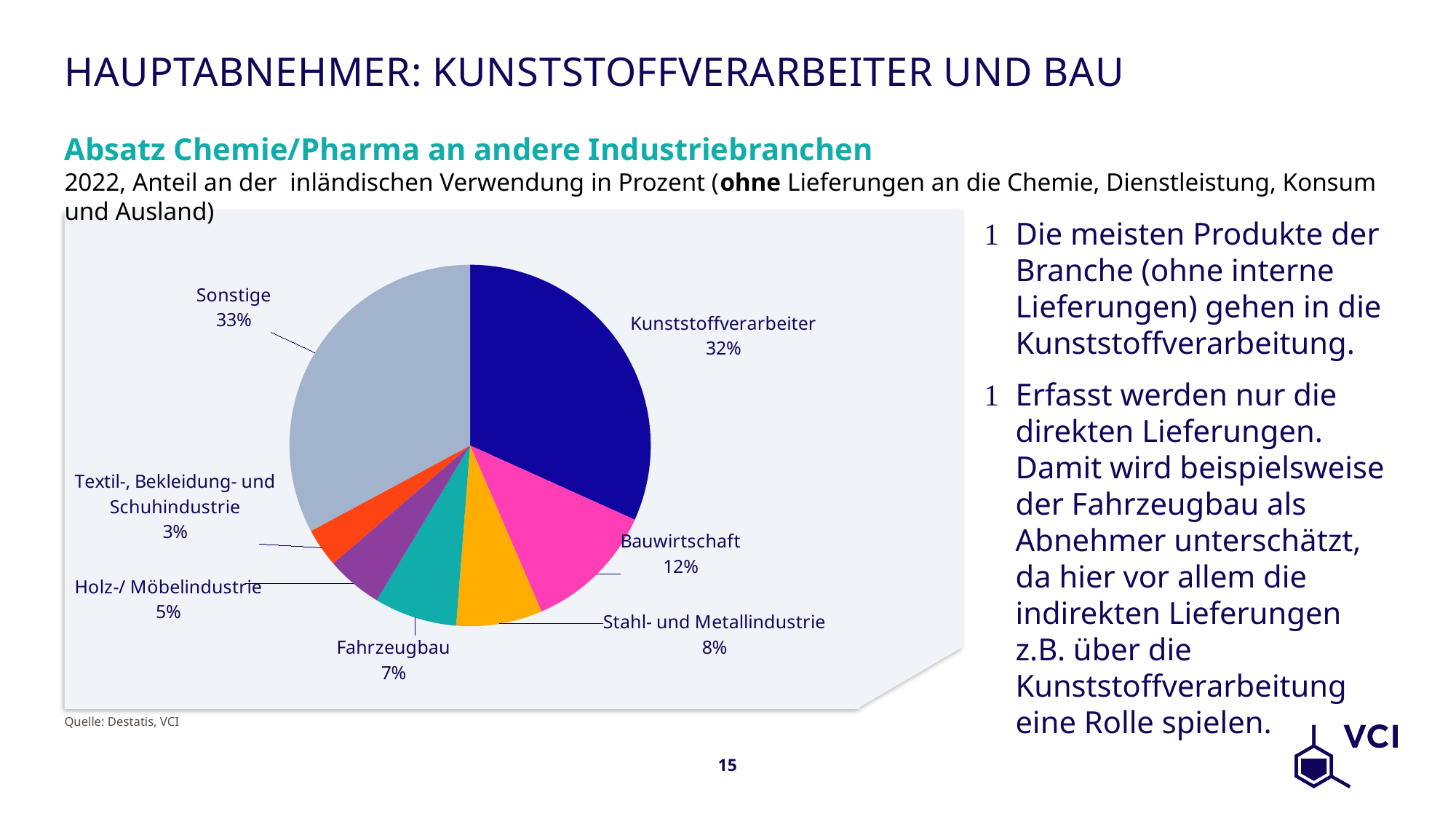
What percentage is shown for Fahrzeugbau? 7% Which category has the smallest slice of the pie? Textil-, Bekleidung- und Schuhindustrie What is the combined share of Kunststoffverarbeiter and Bauwirtschaft? 44% What is the title of the chart on the slide? Absatz Chemie/Pharma an andere Industriebranchen How many categories are shown in the pie chart? 7 Which is larger, the share for Bauwirtschaft or the share for Stahl- und Metallindustrie? Bauwirtschaft What share of the pie does Kunststoffverarbeiter account for? 32% What is the difference in percentage points between Kunststoffverarbeiter and Bauwirtschaft? 20 percentage points What type of chart is shown on the slide? Pie chart What share is shown for Sonstige? 33% What is the share for Holz-/ Möbelindustrie? 5% What is the value shown for Bauwirtschaft? 12%